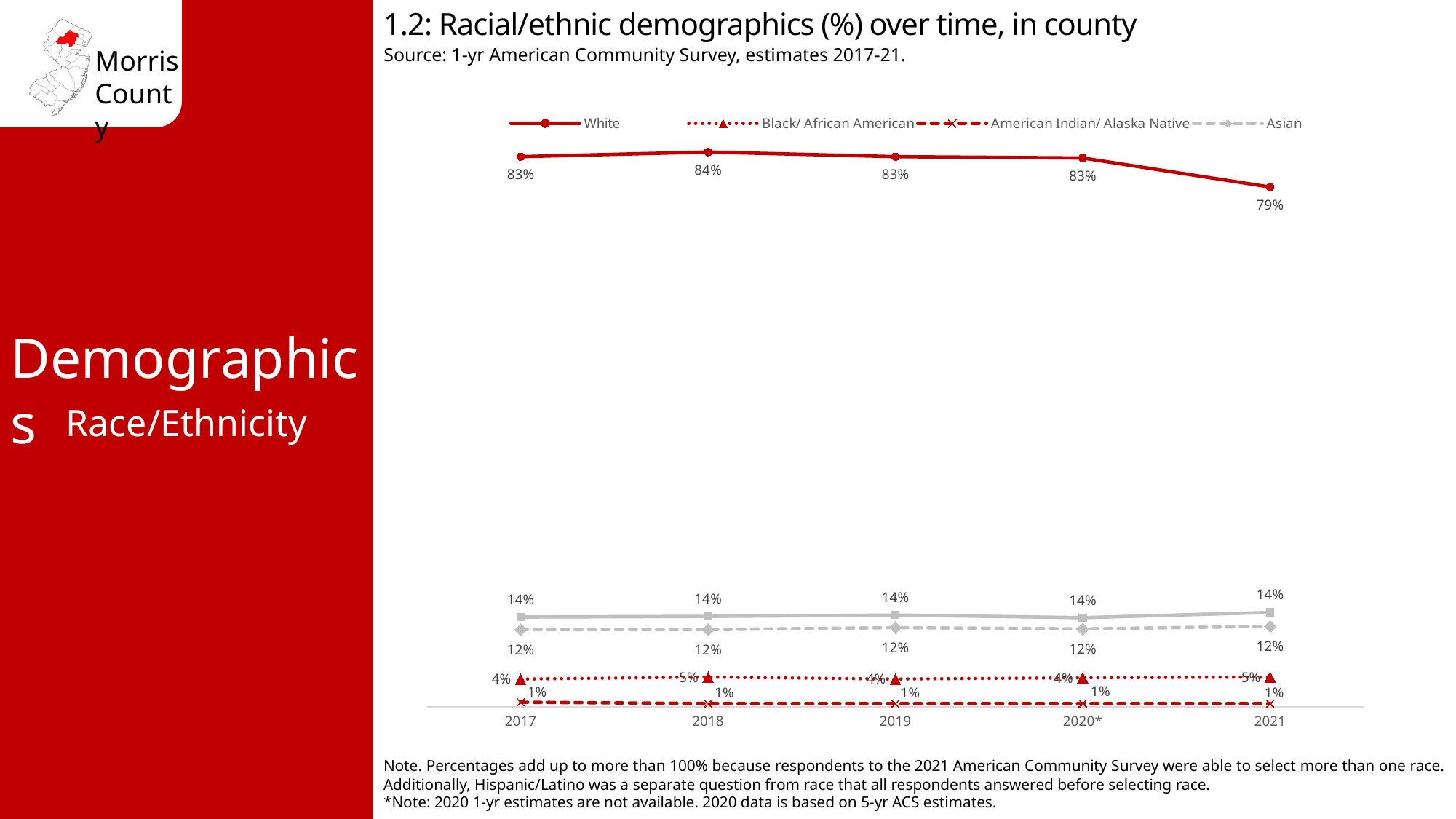
What percentage is shown for White in 2018? 84% What percentage is shown for White in 2021? 79% What percentage is shown for Asian in 2019? 12% In which year is the White percentage highest? 2018 Does the White percentage rise or fall between 2020* and 2021? fall In which year is the White percentage lowest? 2021 What is the difference between the White percentage in 2018 and in 2021? 5% What kind of chart is shown on the slide? line chart How many years are shown on the x axis? 5 Which is larger in 2021, the Asian percentage or the Black/ African American percentage? Asian What percentage is shown for Black/ African American in 2018? 5% What percentage is shown for American Indian/ Alaska Native in 2020*? 1%